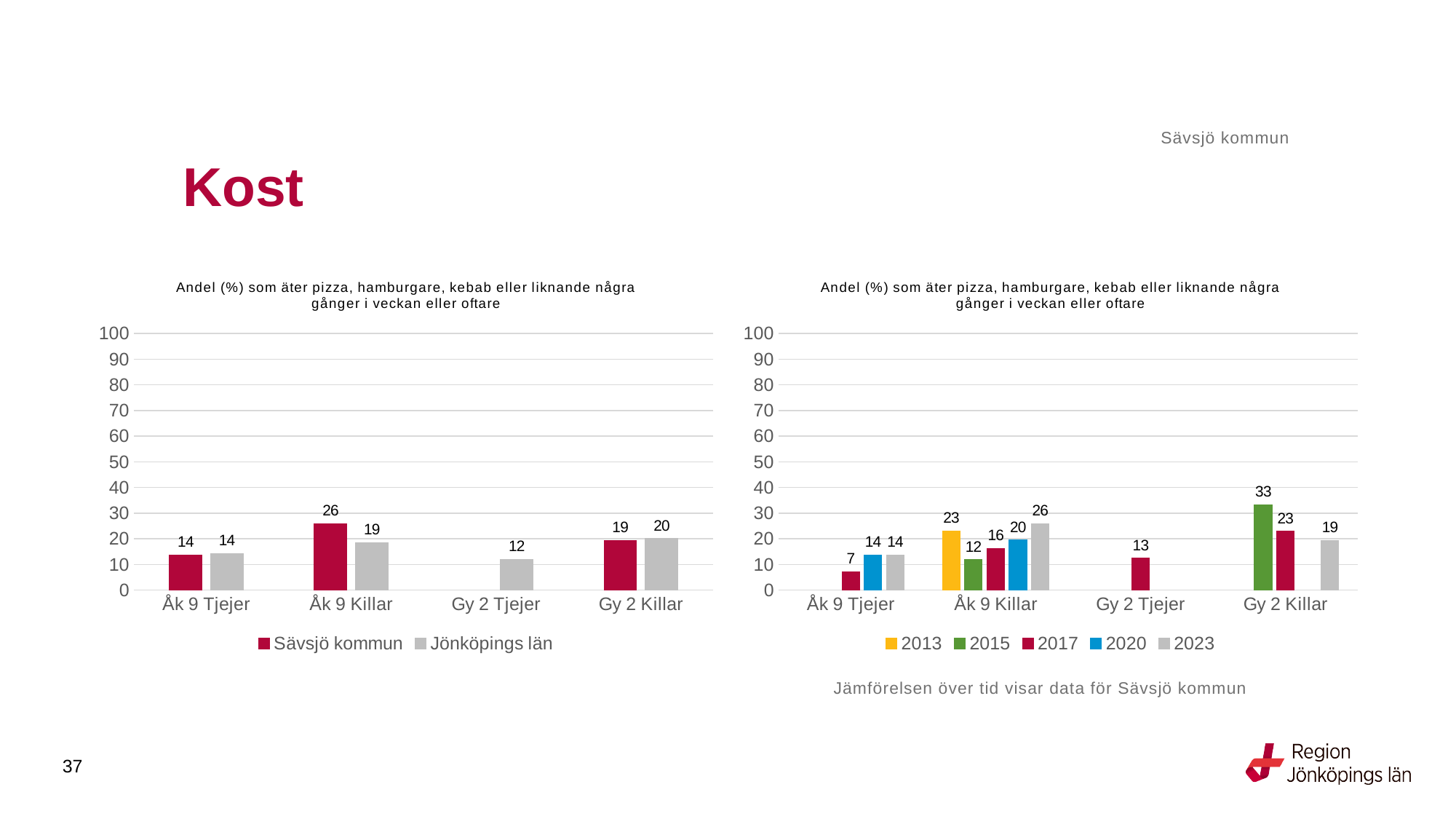
In the left chart, how many series does the legend list? 2 In the right chart, what is the difference between the 2015 and 2023 values for Gy 2 Killar? 14 In the left chart, which is larger for Gy 2 Killar: Sävsjö kommun or Jönköpings län? Jönköpings län In the right chart, what is the value for 2013 for Åk 9 Killar? 23 In the right chart, which year has the highest value for Åk 9 Killar? 2023 In the right chart, which year has the lowest value for Åk 9 Tjejer? 2017 In the left chart, what is the difference between Sävsjö kommun and Jönköpings län for Åk 9 Killar? 7 In the left chart, what is the value for Sävsjö kommun for Åk 9 Killar? 26 In the right chart, what is the value for 2015 for Gy 2 Killar? 33 In the right chart, how many series does the legend list? 5 In the left chart, what is the value for Jönköpings län for Gy 2 Tjejer? 12 What kind of chart is the left chart? Bar chart